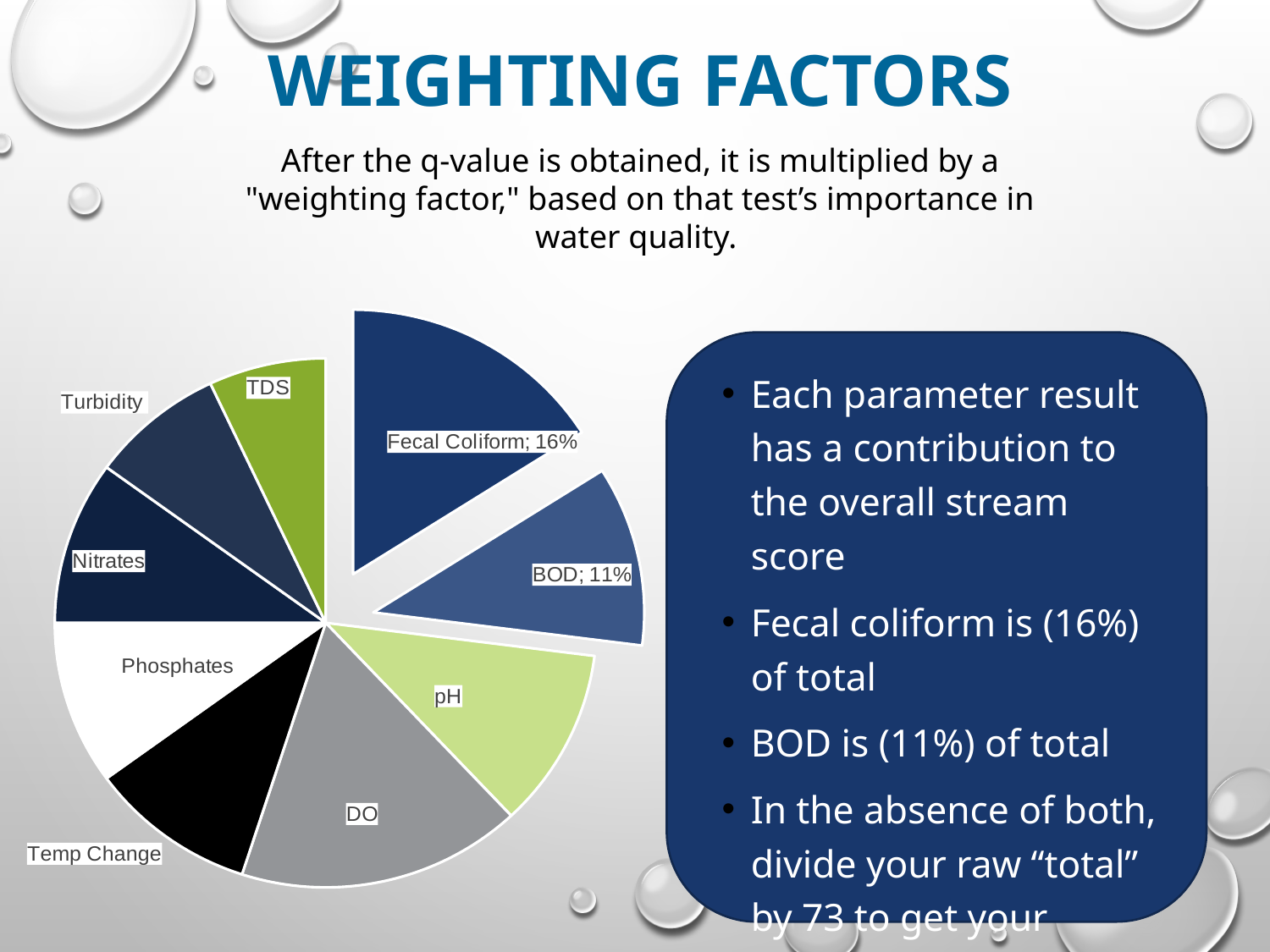
What is the difference between the Fecal Coliform and BOD percentages in the pie chart? 5% What percentage is shown for Fecal Coliform in the pie chart? 16% How many slices does the pie chart have? 9 What kind of chart is shown on the slide? pie chart What colour is the Phosphates slice in the pie chart? white Which slice is larger in the pie chart, DO or TDS? DO Which slice is larger in the pie chart, DO or Turbidity? DO Which two slices of the pie chart have their percentage values printed? Fecal Coliform and BOD What percentage is shown for BOD in the pie chart? 11% Which slice is larger in the pie chart, Fecal Coliform or BOD? Fecal Coliform